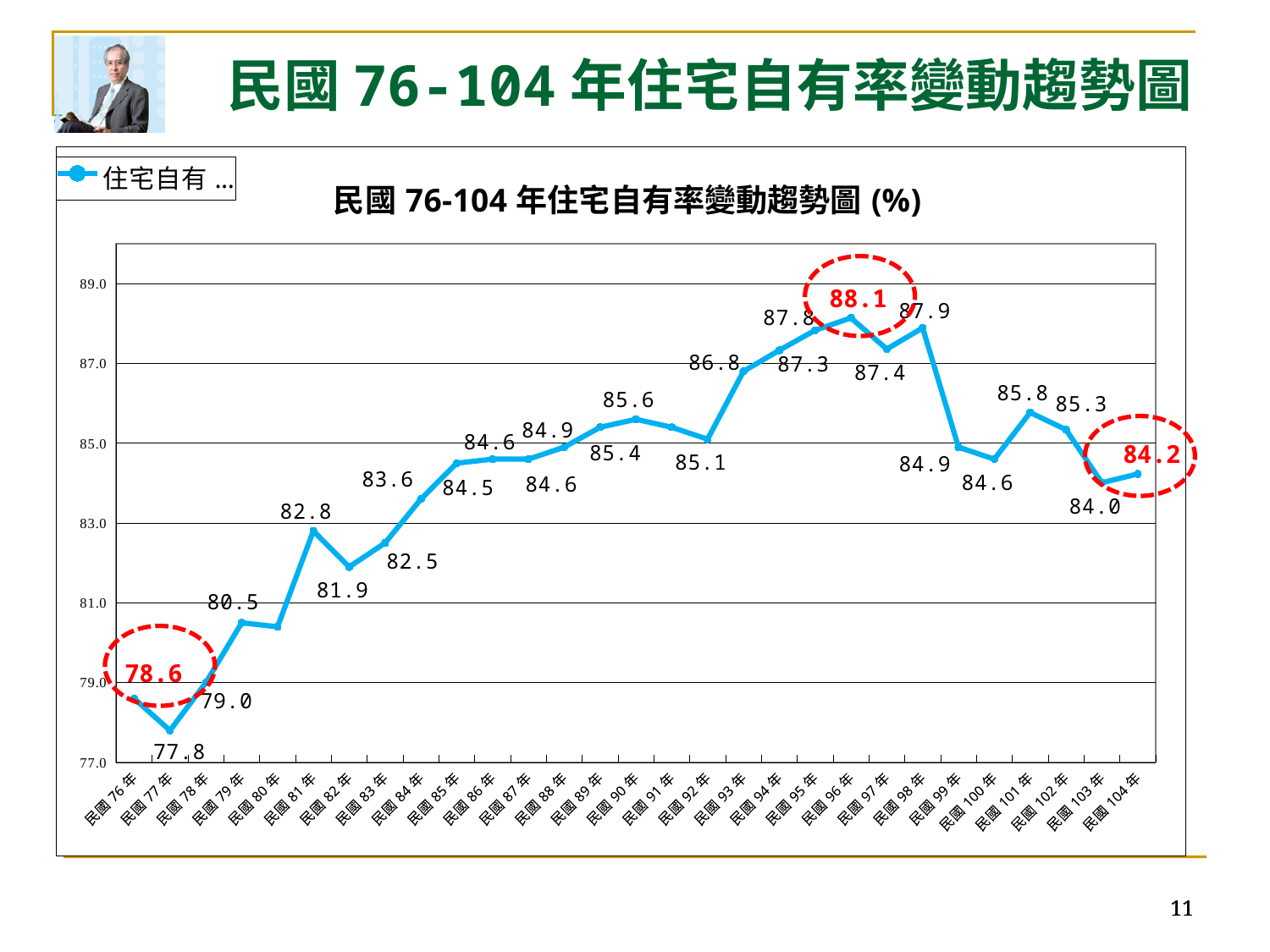
What is the value for 民國 104 年? 84.2 What is the value for 民國 76 年? 78.6 What is the title of the chart? 民國 76-104 年住宅自有率變動趨勢圖 (%) Is the value for 民國 80 年 greater or less than 81.0? less What is the value for 民國 93 年? 86.8 Which is larger, the value for 民國 81 年 or the value for 民國 82 年? 民國 81 年 How many years (data points) are plotted along the x axis? 29 What is the difference between the value for 民國 96 年 and the value for 民國 104 年? 3.9 What is the value for 民國 96 年? 88.1 Which year has the lowest home ownership rate? 民國 77 年 What kind of chart is shown on the slide? line chart Which year has the highest home ownership rate? 民國 96 年